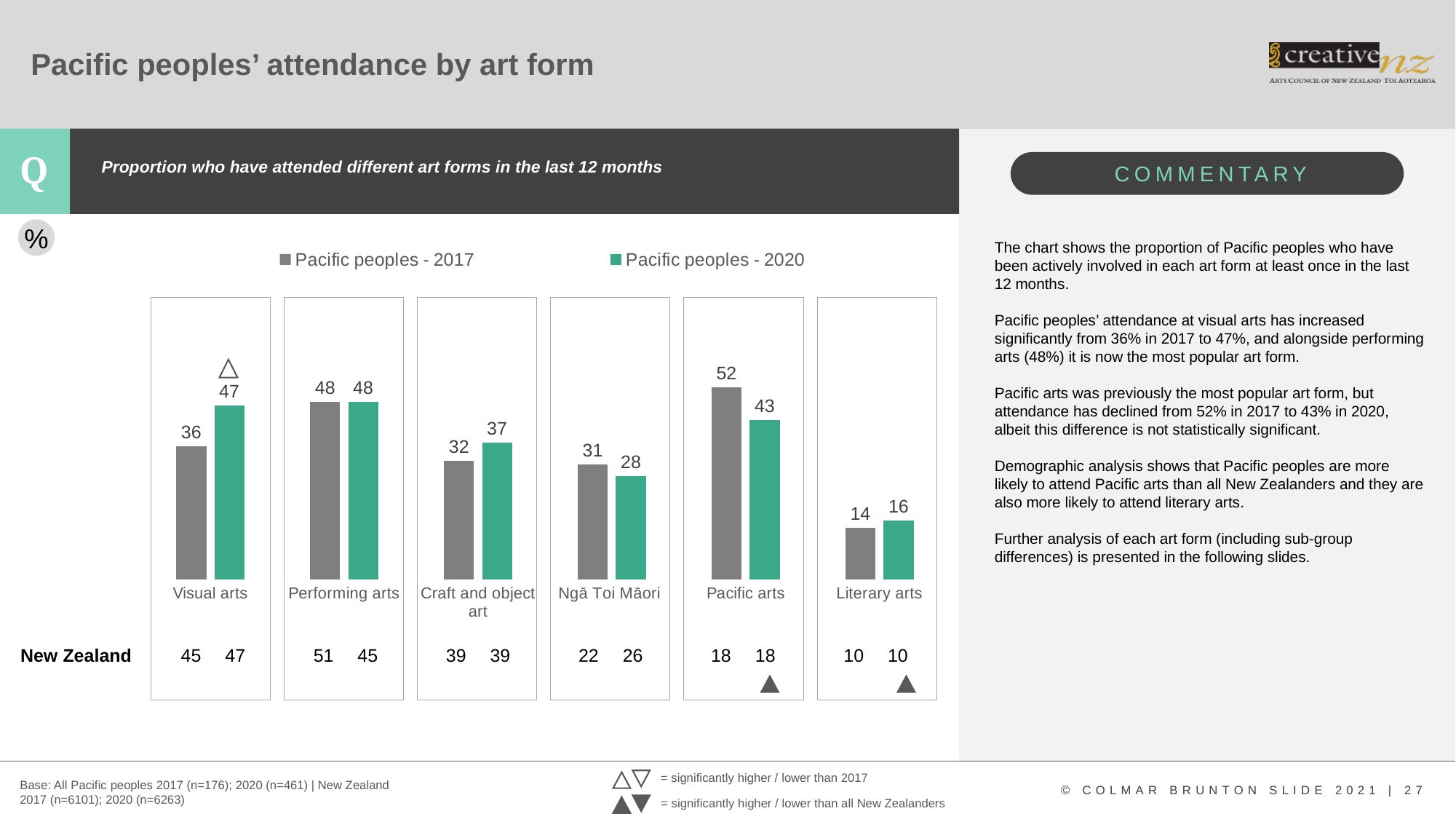
How many art form categories are shown in the chart? 6 What is the value for Pacific arts in the Pacific peoples - 2017 series? 52 How many series does the legend list? 2 What is the value for Literary arts in the Pacific peoples - 2020 series? 16 Which art form has the lowest value in the Pacific peoples - 2020 series? Literary arts Which is larger for Ngā Toi Māori: the Pacific peoples - 2017 value or the Pacific peoples - 2020 value? Pacific peoples - 2017 What is the difference between the 2017 and 2020 values for Pacific arts? 9 What colour represents the Pacific peoples - 2020 series? Green What kind of chart is shown on the slide? Bar chart Which art form has the highest value in the Pacific peoples - 2017 series? Pacific arts What is the difference between the 2017 and 2020 values for Visual arts? 11 What is the value for Visual arts in the Pacific peoples - 2020 series? 47